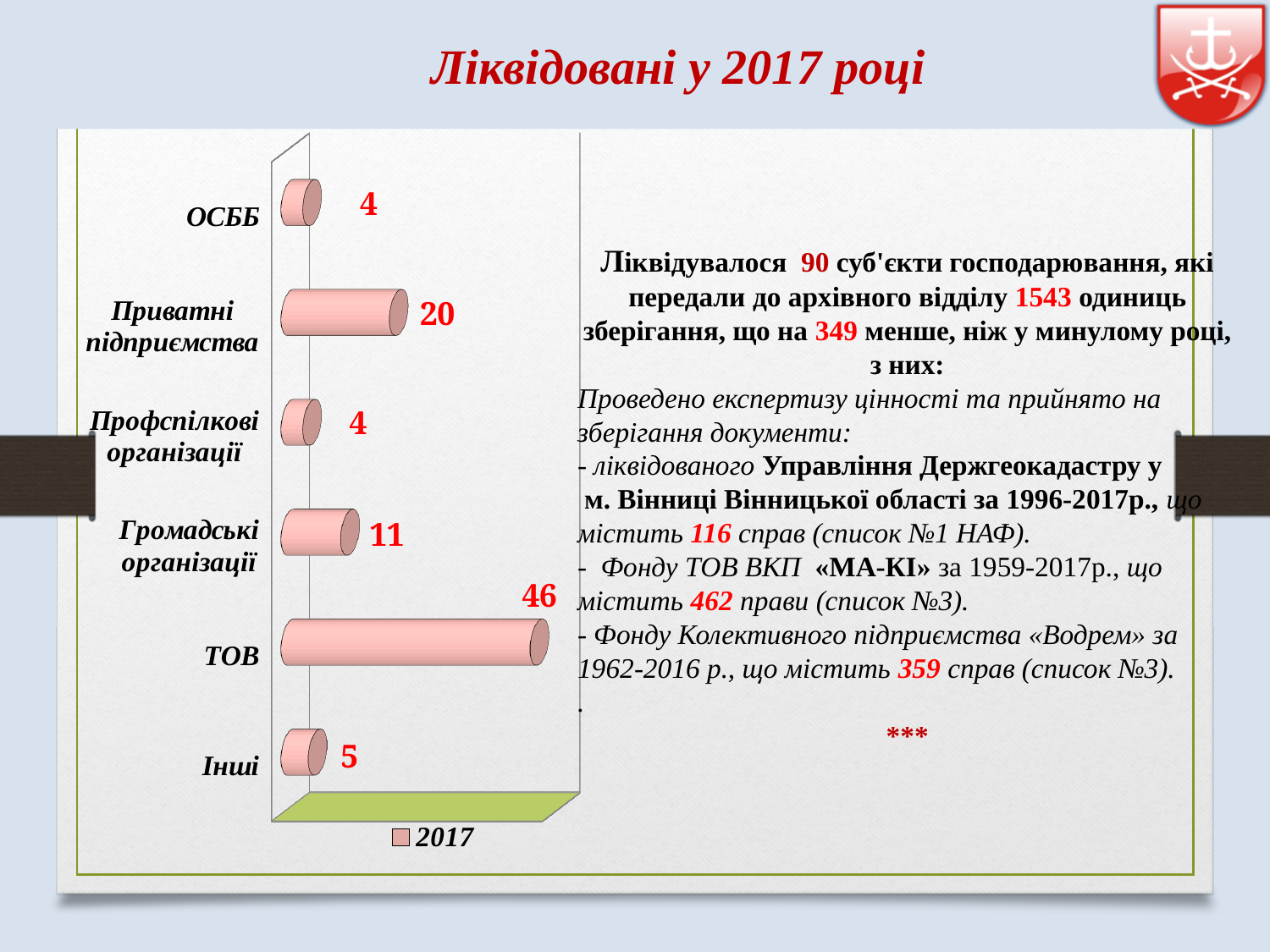
What is the value for Інші in the chart? 5 What is the difference between the values for ТОВ and Приватні підприємства? 26 What is the value for ТОВ in the chart? 46 How many categories are shown in the chart? 6 Which category has the highest value in the chart? ТОВ What is the value for Приватні підприємства in the chart? 20 What series name is shown in the chart legend? 2017 What is the difference between the values for Громадські організації and Інші? 6 What kind of chart is shown on the slide? Bar chart How many series does the chart legend list? 1 Which is larger, the value for Приватні підприємства or the value for Громадські організації? Приватні підприємства What is the value for Громадські організації in the chart? 11